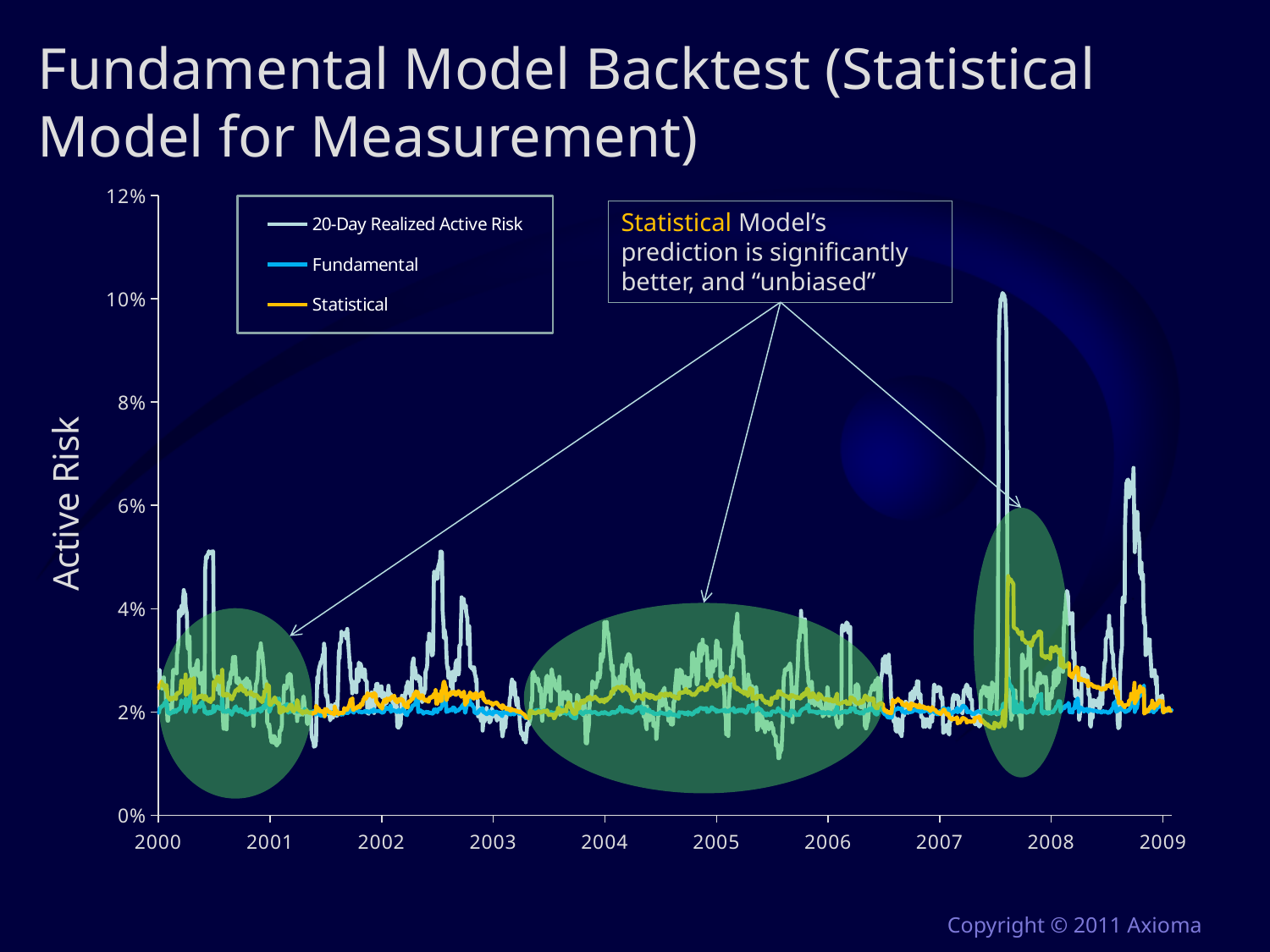
How many year labels are shown along the horizontal axis? 10 How many series does the legend list? 3 What kind of chart is shown on the slide? Line chart At the spike in late 2007, which series is higher: 20-Day Realized Active Risk or Statistical? 20-Day Realized Active Risk What is the highest value shown on the vertical axis? 12% Is the peak value of the 20-Day Realized Active Risk series in late 2007 greater or less than 8%? greater Is the peak of the 20-Day Realized Active Risk series in late 2008 greater or less than 6%? greater What is the label on the vertical axis? Active Risk Is the value of the Fundamental series during 2005 greater or less than 4%? less Which series reaches the highest value anywhere on the chart? 20-Day Realized Active Risk During 2005, which series is higher: Statistical or Fundamental? Statistical